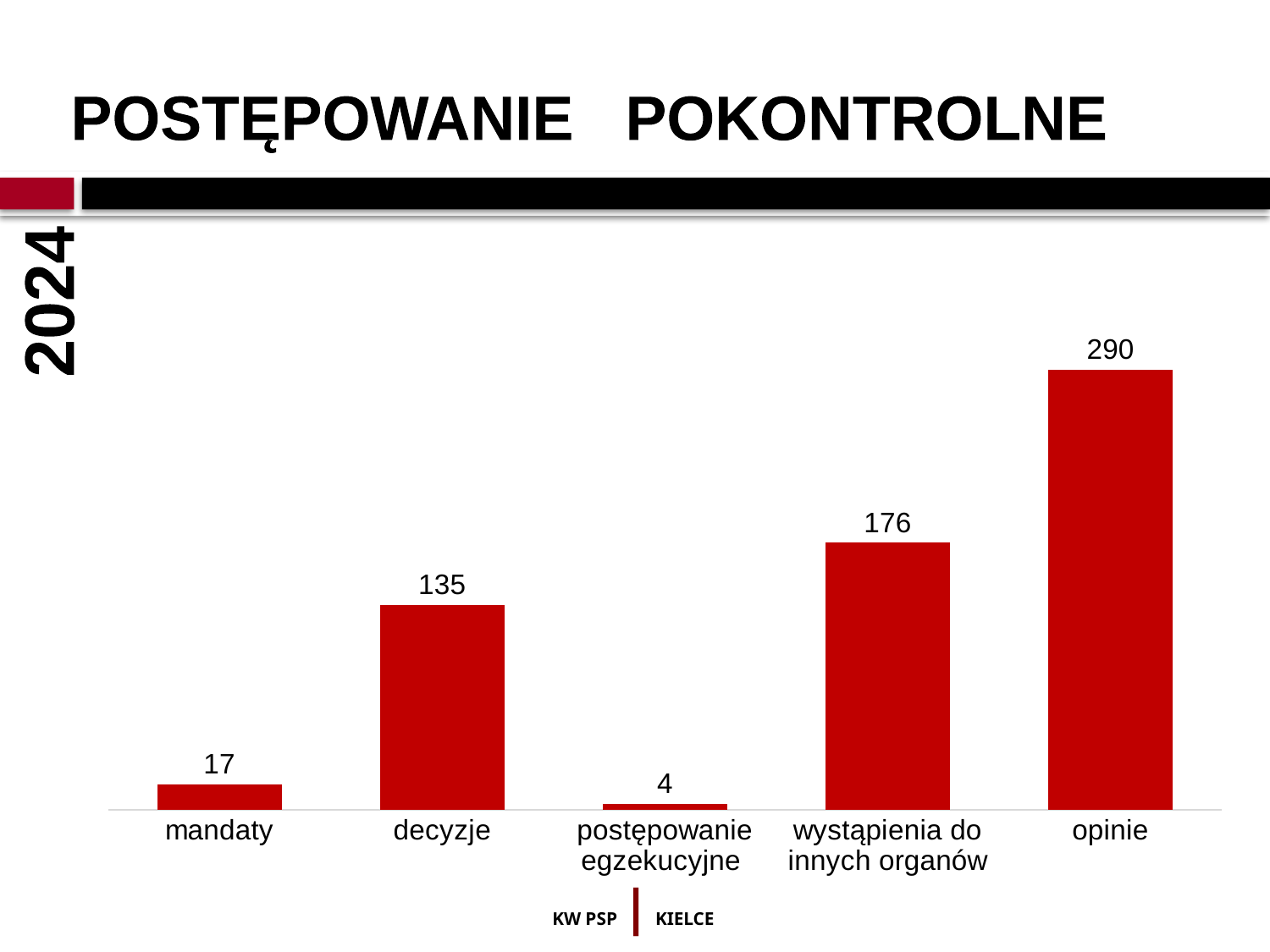
What is the value for mandaty? 17 Which category has the lowest value? postępowanie egzekucyjne What is the value for wystąpienia do innych organów? 176 How many categories are shown in the chart? 5 What is the difference between the values for opinie and wystąpienia do innych organów? 114 What is the title of the slide containing the chart? POSTĘPOWANIE POKONTROLNE What is the value for decyzje? 135 What is the value for postępowanie egzekucyjne? 4 What kind of chart is shown on the slide? bar chart Which category has the highest value? opinie Which is larger, the value for decyzje or the value for mandaty? decyzje What is the value for opinie? 290